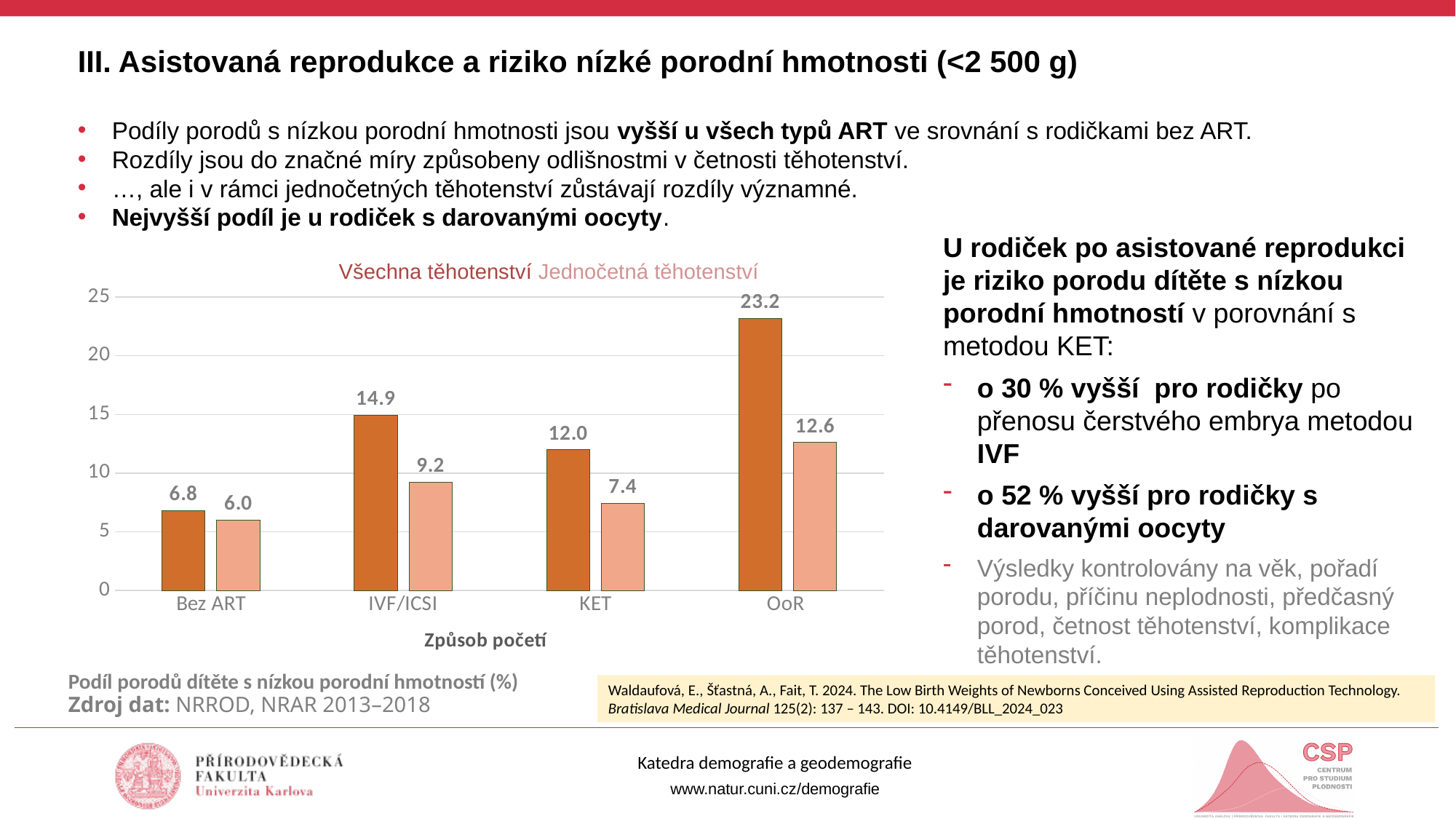
What is the value for 'Všechna těhotenství' in the KET category? 12.0 Which is larger: the 'Všechna těhotenství' value for IVF/ICSI or for KET? IVF/ICSI What is the value for 'Všechna těhotenství' in the OoR category? 23.2 How many categories are shown on the x axis? 4 What is the x-axis title of the chart? Způsob početí Which category has the highest value for 'Všechna těhotenství'? OoR How many series does the legend list? 2 What is the difference between the 'Všechna těhotenství' and 'Jednočetná těhotenství' values for OoR? 10.6 Which category has the lowest value for 'Jednočetná těhotenství'? Bez ART What is the value for 'Jednočetná těhotenství' in the Bez ART category? 6.0 What kind of chart is shown on the slide? Bar chart What is the value for 'Jednočetná těhotenství' in the IVF/ICSI category? 9.2